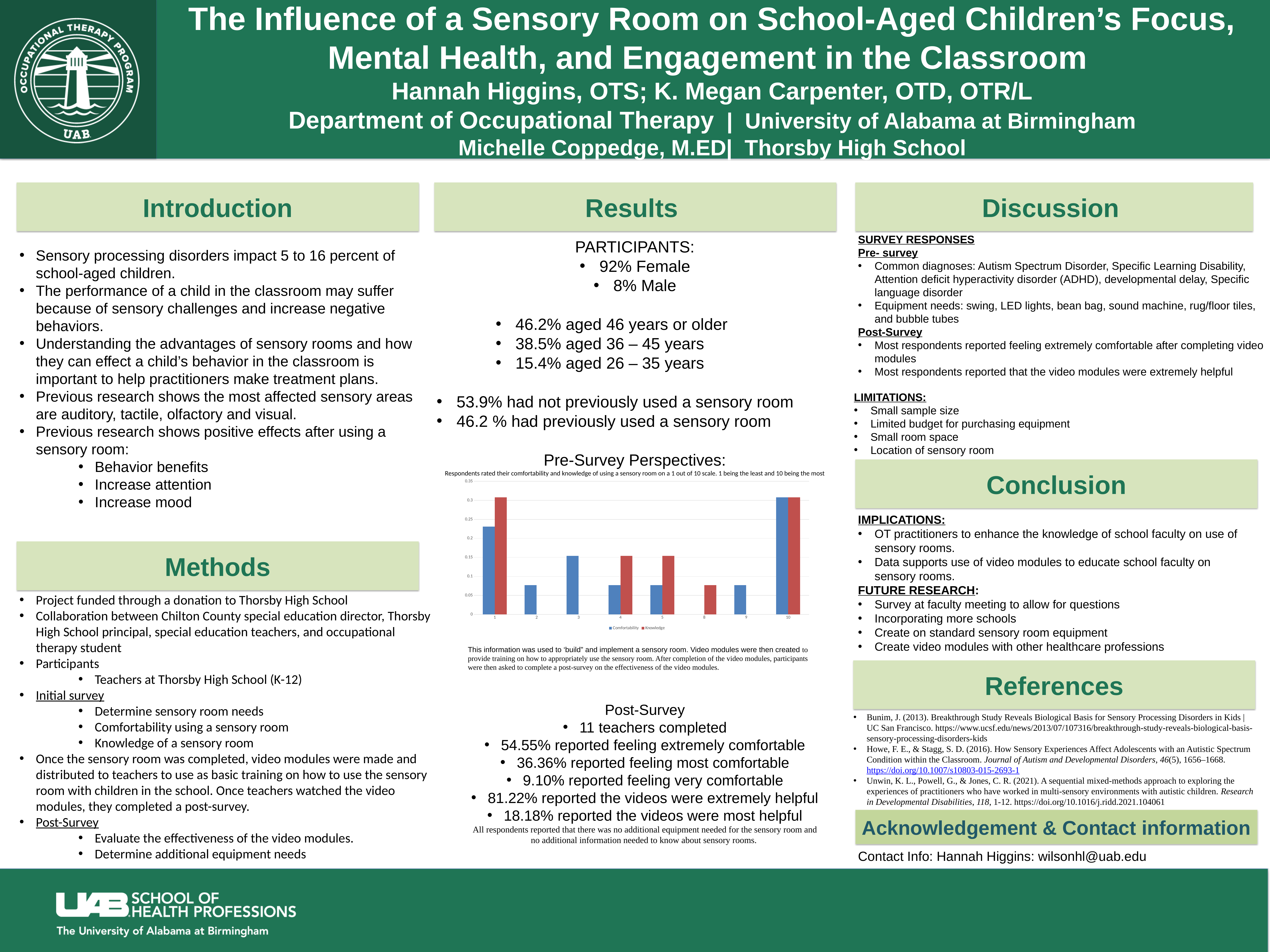
In the Pre-Survey Perspectives chart, for rating 1, which series has the larger value, Comfortability or Knowledge? Knowledge In the Pre-Survey Perspectives chart, for rating 3, which series has the larger value, Comfortability or Knowledge? Comfortability In the Pre-Survey Perspectives chart, is the Comfortability value for rating 2 greater or less than 0.1? less How many rating categories are shown on the x axis of the Pre-Survey Perspectives chart? 8 How many series does the legend of the Pre-Survey Perspectives chart list? 2 In the Pre-Survey Perspectives chart, is the Knowledge value for rating 8 greater or less than 0.1? less In the Pre-Survey Perspectives chart, which colour represents the Knowledge series? red What kind of chart is the Pre-Survey Perspectives chart? bar chart In the Pre-Survey Perspectives chart, which rating category has the highest Comfortability value? 10 In the Pre-Survey Perspectives chart, is the Comfortability value for rating 1 greater or less than 0.2? greater What are the two series named in the legend of the Pre-Survey Perspectives chart? Comfortability and Knowledge